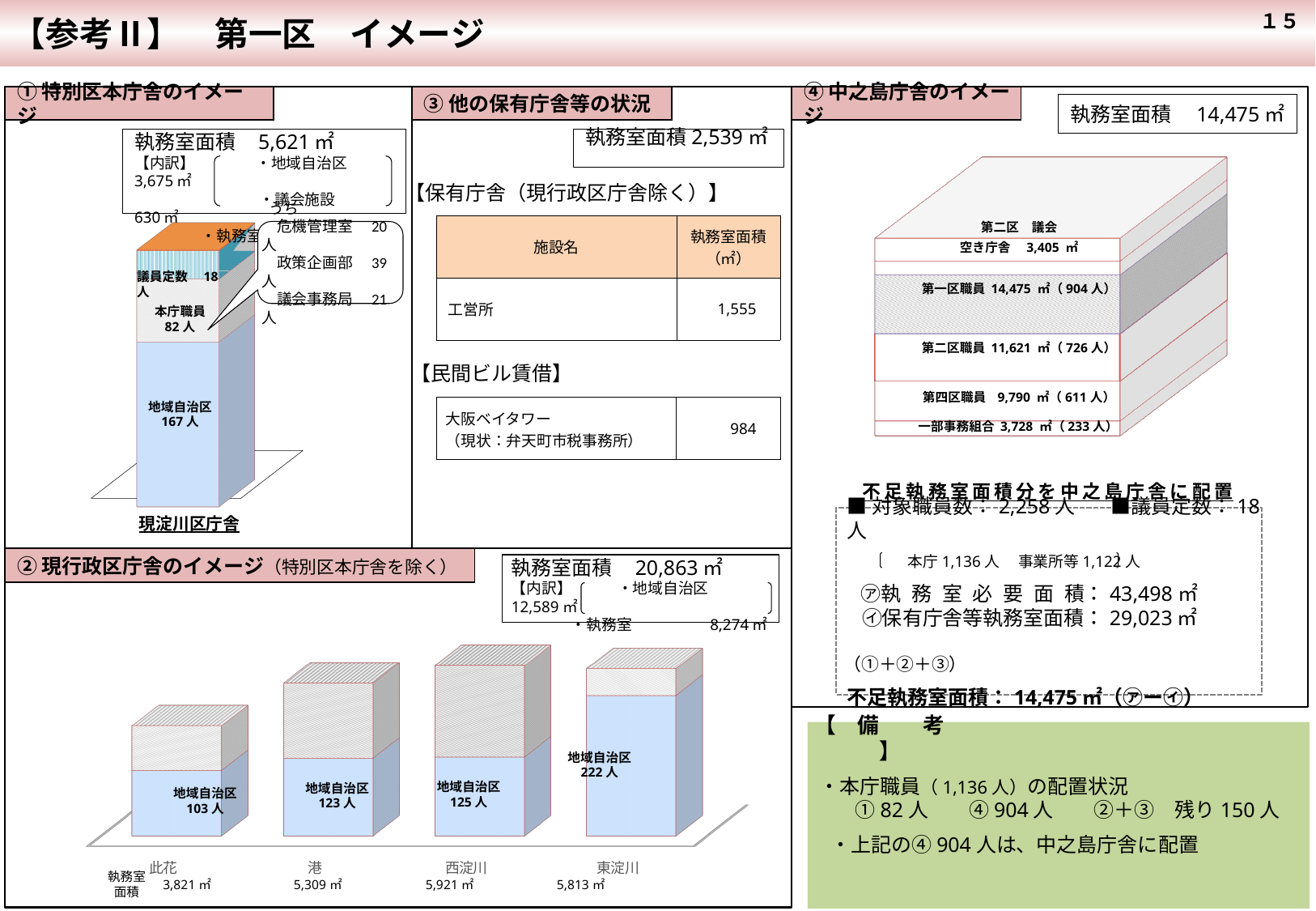
In the ② 現行政区庁舎のイメージ chart, which building has the most 地域自治区 people? 東淀川 In the ② 現行政区庁舎のイメージ chart, what is the difference in 執務室面積 between 西淀川 and 此花? 2,100 ㎡ In the ② 現行政区庁舎のイメージ chart, what is the 執務室面積 for 港? 5,309 ㎡ In the ② 現行政区庁舎のイメージ chart, which building has the smallest 執務室面積? 此花 In the ④ 中之島庁舎のイメージ diagram, what is the area shown for 第二区職員? 11,621 ㎡ In the ① 特別区本庁舎のイメージ diagram, how many 本庁職員 are shown? 82 人 In the ② 現行政区庁舎のイメージ chart, how many 地域自治区 people are shown for 東淀川? 222 人 In the ② 現行政区庁舎のイメージ chart, which has the larger 執務室面積, 港 or 東淀川? 東淀川 In the ② 現行政区庁舎のイメージ chart, how many buildings (categories) are shown? 4 In the ② 現行政区庁舎のイメージ chart, what is the total 執務室面積 shown in the box above the chart? 20,863 ㎡ In the ④ 中之島庁舎のイメージ diagram, how many people are shown for 第四区職員? 611 人 In the ② 現行政区庁舎のイメージ chart, which building has the largest 執務室面積? 西淀川